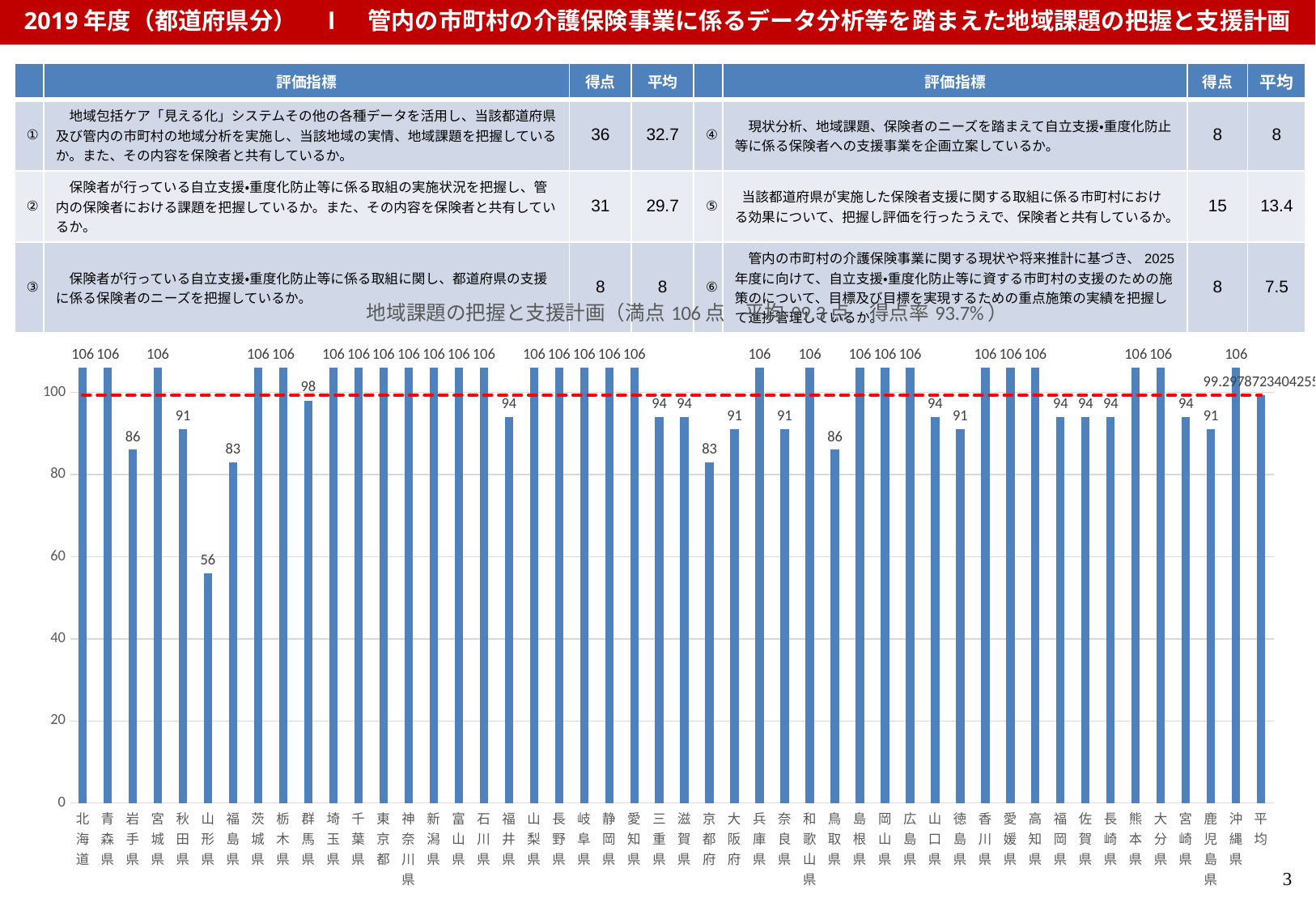
What is the difference between the values for 北海道 and 山形県? 50 What kind of chart is shown on the slide? combination bar and line chart (bars with a dashed average line) What is the value for 山形県 in the bar chart? 56 Which has the larger value, 岩手県 or 福島県? 岩手県 What full score (満点) is stated in the chart title? 106 点 What is the value for 群馬県 in the bar chart? 98 How many bars are plotted in the chart, including the 平均 bar? 48 Which prefecture has the lowest value in the bar chart? 山形県 What is the difference between the values for 群馬県 and 岩手県? 12 What is the highest value shown on any bar in the chart? 106 What is the value for 京都府 in the bar chart? 83 Is the value for 秋田県 greater or less than 80? greater